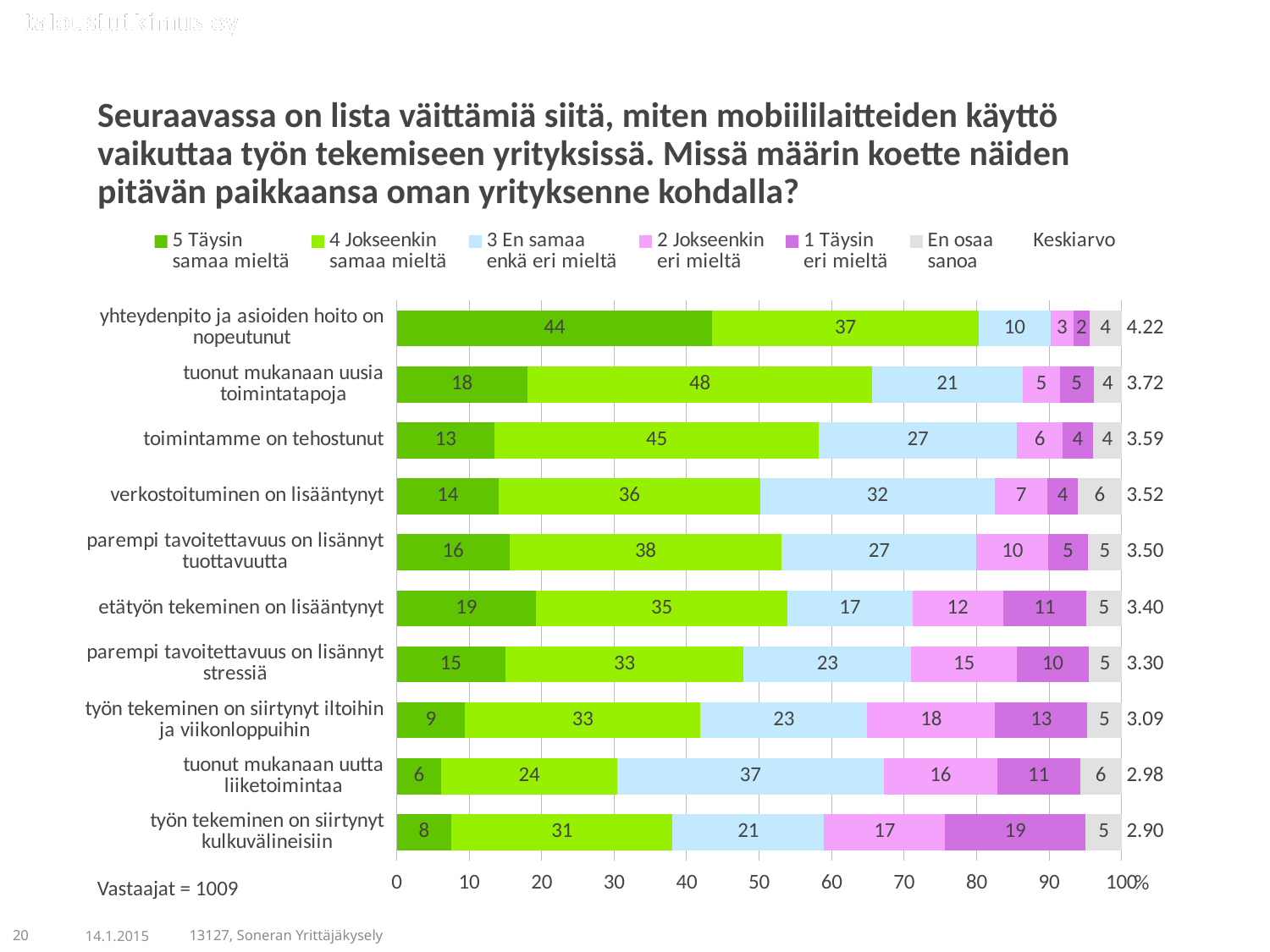
What is the value of '5 Täysin samaa mieltä' for 'yhteydenpito ja asioiden hoito on nopeutunut'? 44 Which statement has the lowest Keskiarvo (mean) value? työn tekeminen on siirtynyt kulkuvälineisiin Which statement has the highest Keskiarvo (mean) value? yhteydenpito ja asioiden hoito on nopeutunut Which statement has the highest value for '4 Jokseenkin samaa mieltä'? tuonut mukanaan uusia toimintatapoja How many statements (categories) are plotted in the chart? 10 What is the Keskiarvo (mean) shown for 'toimintamme on tehostunut'? 3.59 What is the combined value of '5 Täysin samaa mieltä' and '4 Jokseenkin samaa mieltä' for 'verkostoituminen on lisääntynyt'? 50 What type of chart is shown on the slide? stacked bar chart How many response categories does the legend list (excluding the Keskiarvo heading)? 6 Which is larger: the '2 Jokseenkin eri mieltä' value for 'työn tekeminen on siirtynyt iltoihin ja viikonloppuihin' or for 'parempi tavoitettavuus on lisännyt stressiä'? työn tekeminen on siirtynyt iltoihin ja viikonloppuihin What is the value of '1 Täysin eri mieltä' for 'työn tekeminen on siirtynyt kulkuvälineisiin'? 19 What is the difference between the '3 En samaa enkä eri mieltä' values for 'tuonut mukanaan uutta liiketoimintaa' and 'etätyön tekeminen on lisääntynyt'? 20